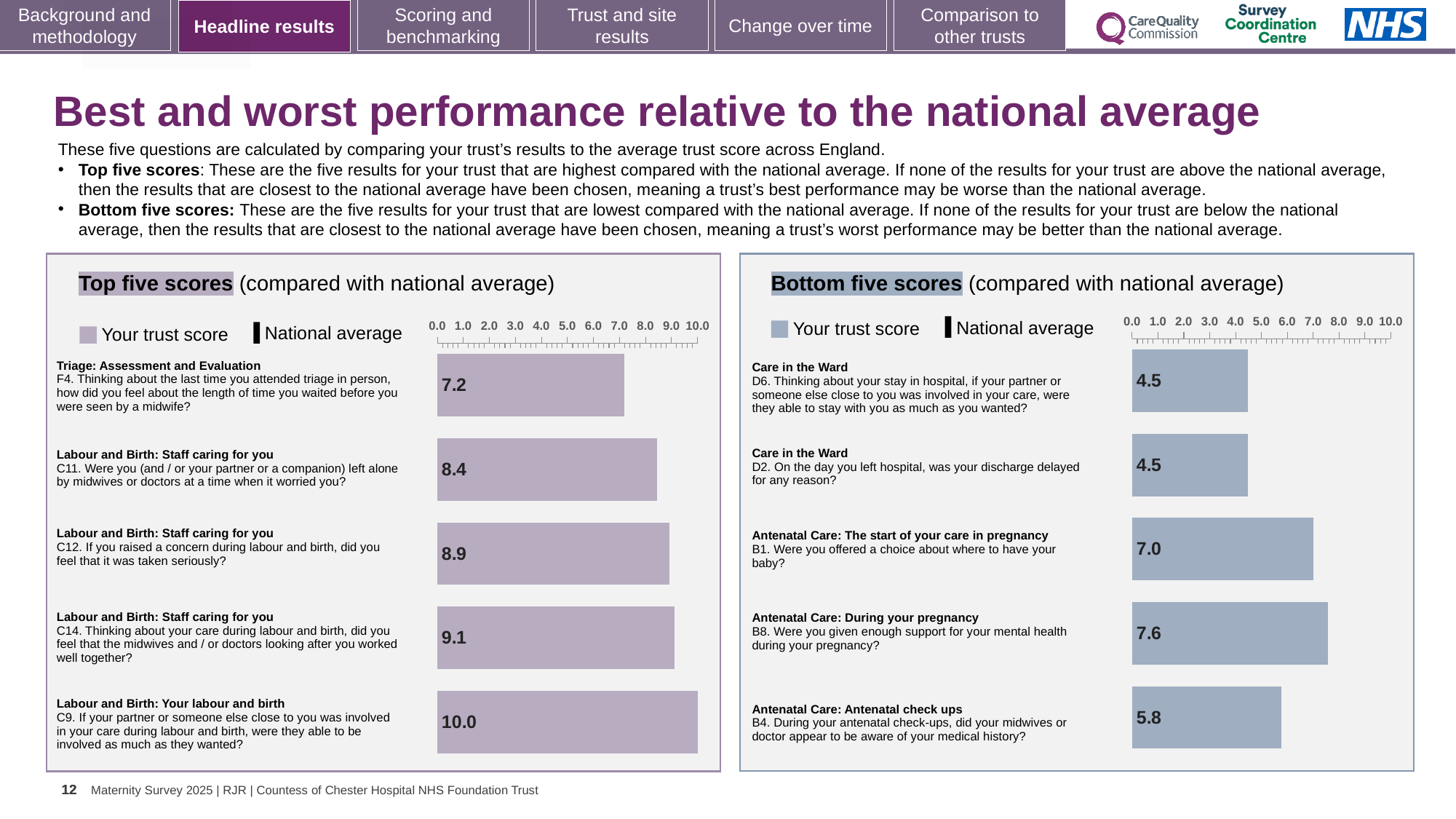
In the Top five scores chart, what is the trust score for question C9 (Labour and Birth: Your labour and birth)? 10.0 In the Bottom five scores chart, what is the trust score for question B8 (Antenatal Care: During your pregnancy)? 7.6 In the Bottom five scores chart, what is the difference between the trust scores for B8 and B1? 0.6 What type of chart is used in the Top five scores panel? Bar chart In the Top five scores chart, what is the difference between the trust scores for C9 and F4? 2.8 In the Top five scores chart, which question has the lowest trust score? F4 How many bars are shown in the Bottom five scores chart? 5 In the Top five scores chart, what is the trust score for question F4 (Triage: Assessment and Evaluation)? 7.2 In the Bottom five scores chart, what is the trust score for question B4 (Antenatal Care: Antenatal check ups)? 5.8 In the Bottom five scores chart, which question has the highest trust score? B8 In the Bottom five scores chart, which has the larger trust score, B1 or B4? B1 In the Top five scores chart, which question has the highest trust score? C9